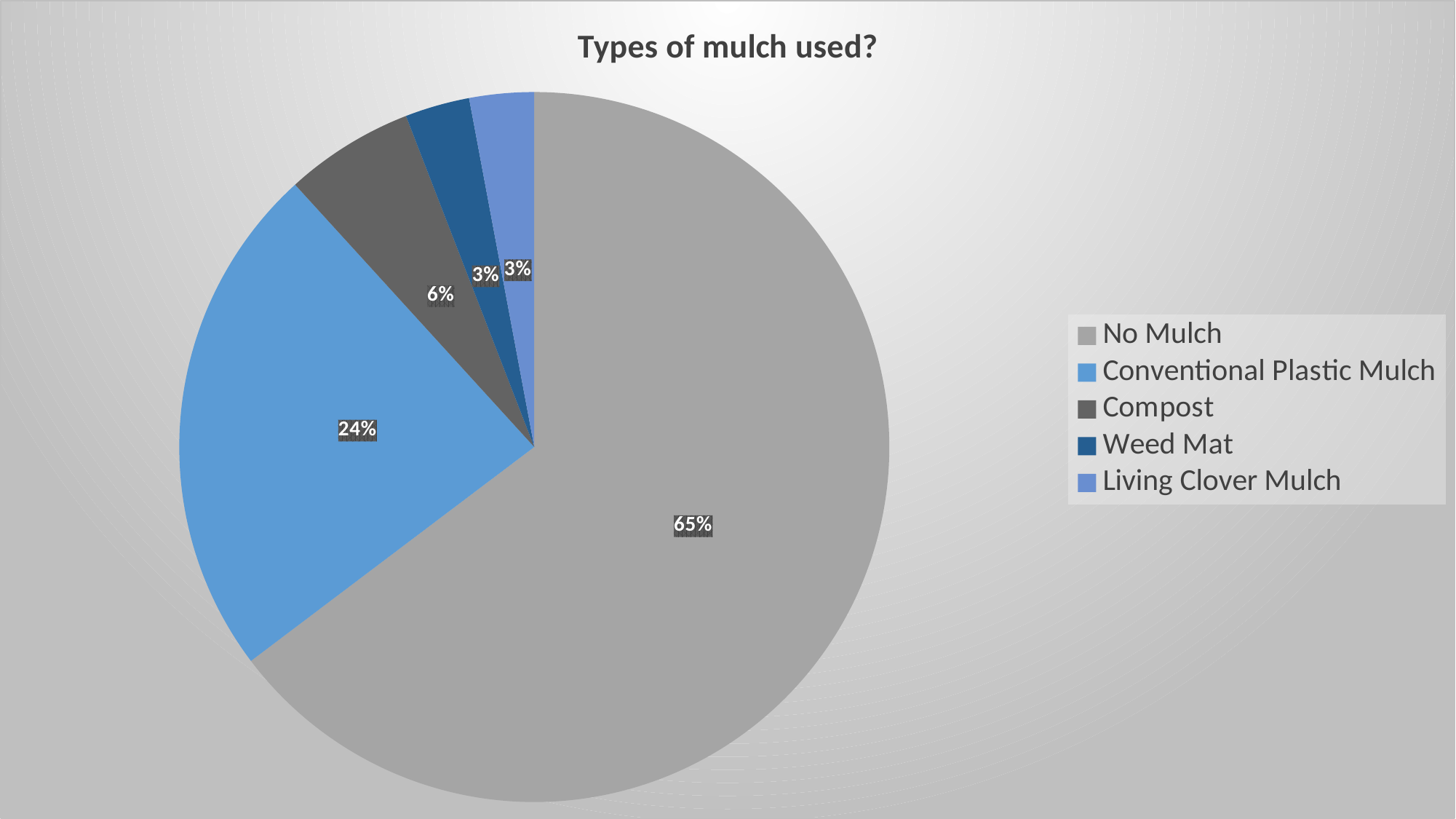
Which category has the largest slice of the pie? No Mulch What share of the pie is Conventional Plastic Mulch? 24% How many categories does the legend list? 5 What is the difference between the No Mulch share and the Conventional Plastic Mulch share? 41% What is the difference between the Conventional Plastic Mulch share and the Compost share? 18% What colour is the No Mulch slice? grey Which is larger, the Compost share or the Weed Mat share? Compost What share of the pie is Compost? 6% What share of the pie is No Mulch? 65% What type of chart is shown on the slide? pie chart What is the title of the chart? Types of mulch used?